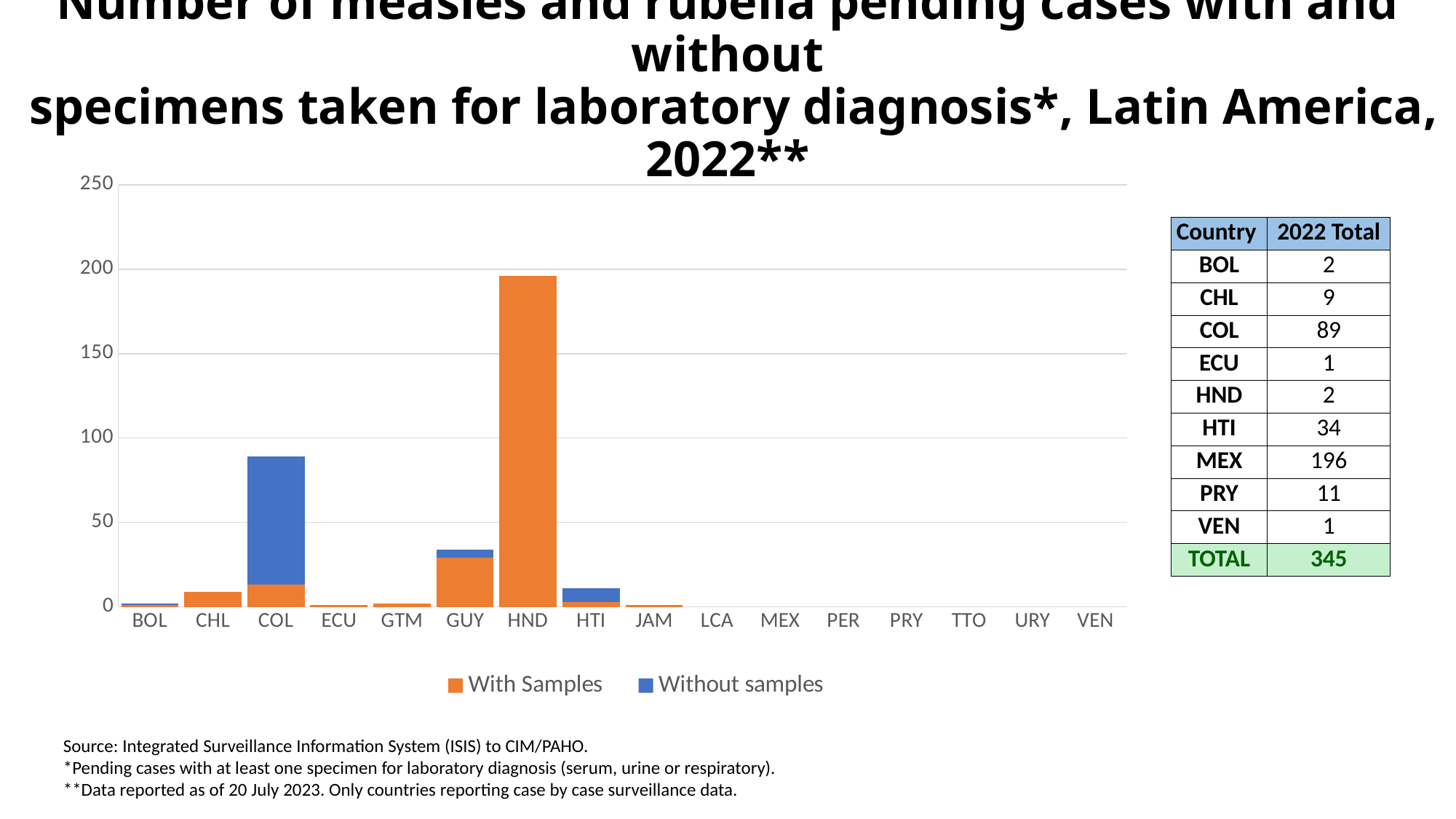
How many countries are shown on the x axis of the chart? 16 Is the total bar height for GUY greater or less than 50? less For COL, which series makes up the larger part of the bar, With Samples or Without samples? Without samples How many series does the chart legend list? 2 Which country has a taller bar, COL or GUY? COL Is the total bar height for COL greater or less than 50? greater Which country has the tallest bar in the chart? HND What kind of chart is shown on the slide? Stacked bar chart Which country has a taller bar, HND or COL? HND Is the total bar height for HTI greater or less than 50? less Which colour represents the 'With Samples' series in the chart? Orange